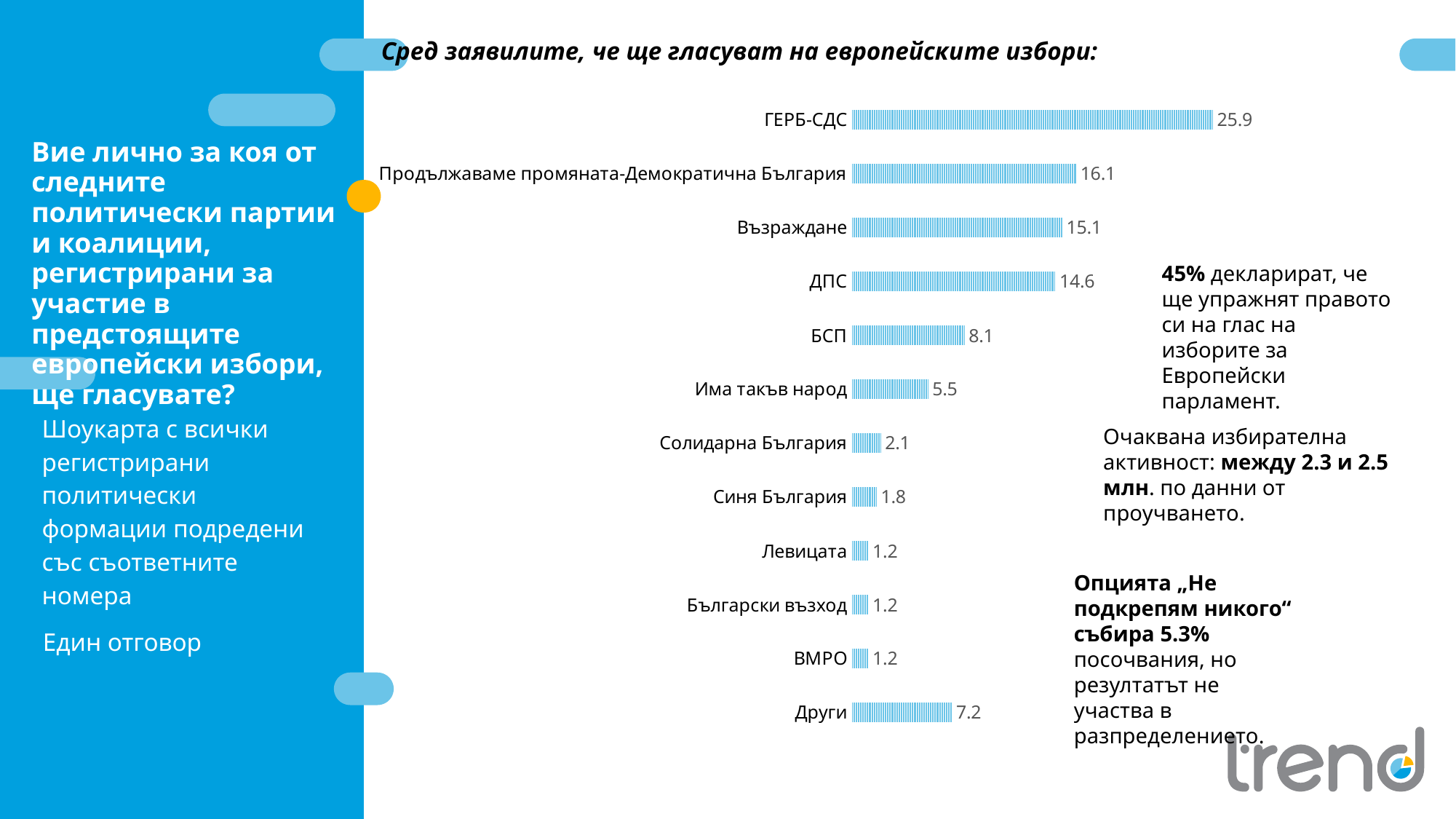
What is the value for ГЕРБ-СДС? 25.9 What is the value for Възраждане? 15.1 Which is larger, the value for Солидарна България or the value for Синя България? Солидарна България What is the value for Други? 7.2 Which is larger, the value for Възраждане or the value for ДПС? Възраждане What is the value for Има такъв народ? 5.5 What is the title of the chart? Сред заявилите, че ще гласуват на европейските избори: Which category has the highest value? ГЕРБ-СДС How many categories are shown in the chart? 12 What is the difference between the values for ГЕРБ-СДС and Продължаваме промяната-Демократична България? 9.8 What kind of chart is shown on the slide? Bar chart What is the difference between the values for ДПС and БСП? 6.5